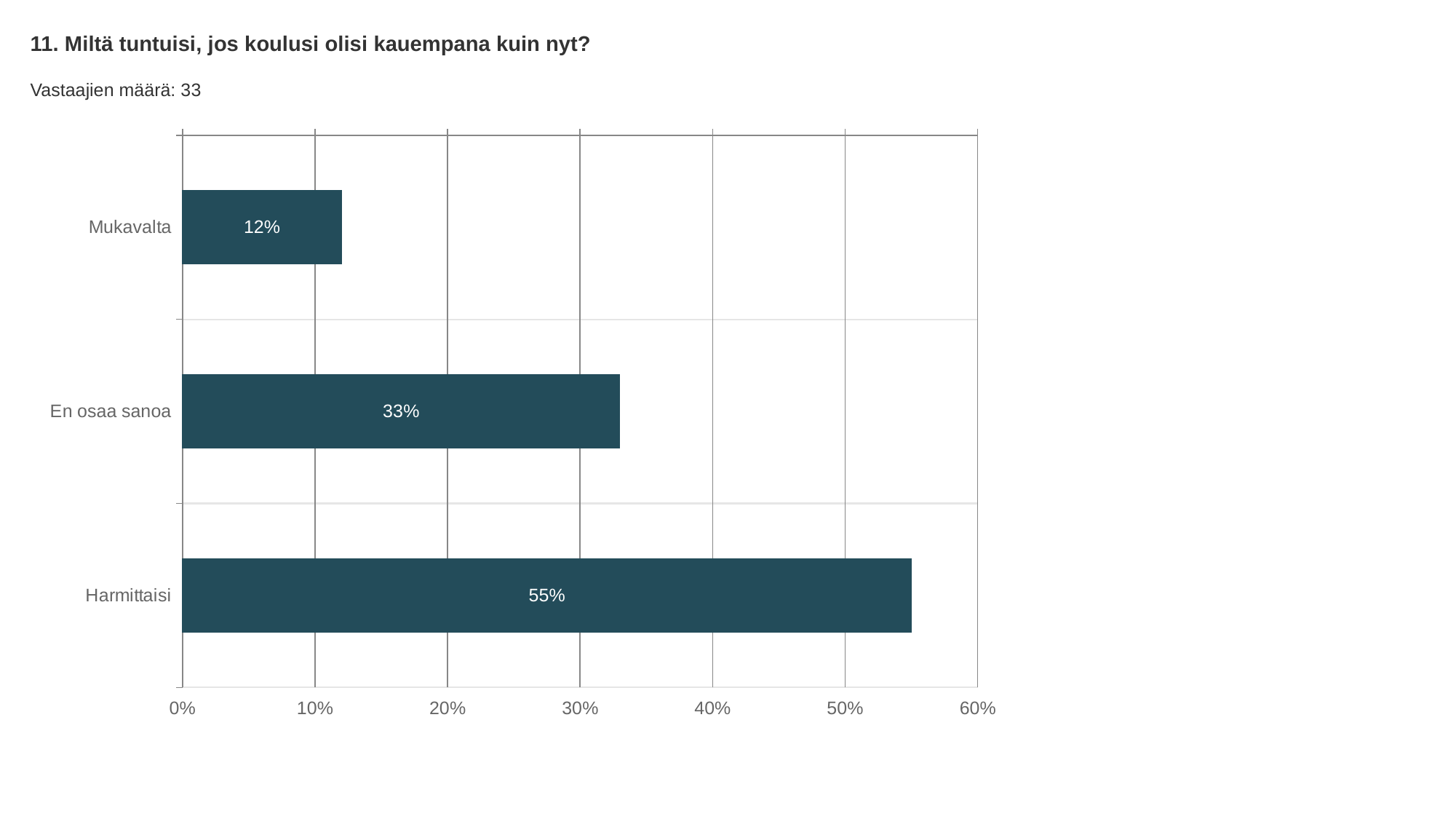
What is the value for En osaa sanoa? 33% Is the value for Harmittaisi greater or less than 50%? greater Which is larger, the value for Mukavalta or the value for En osaa sanoa? En osaa sanoa What is the value for Harmittaisi? 55% What is the value for Mukavalta? 12% How many categories are shown in the chart? 3 What is the difference between the values for Harmittaisi and En osaa sanoa? 22% What is the difference between the values for En osaa sanoa and Mukavalta? 21% How many respondents (Vastaajien määrä) does the slide report? 33 Which category has the highest value? Harmittaisi Which category has the lowest value? Mukavalta What kind of chart is shown on the slide? bar chart